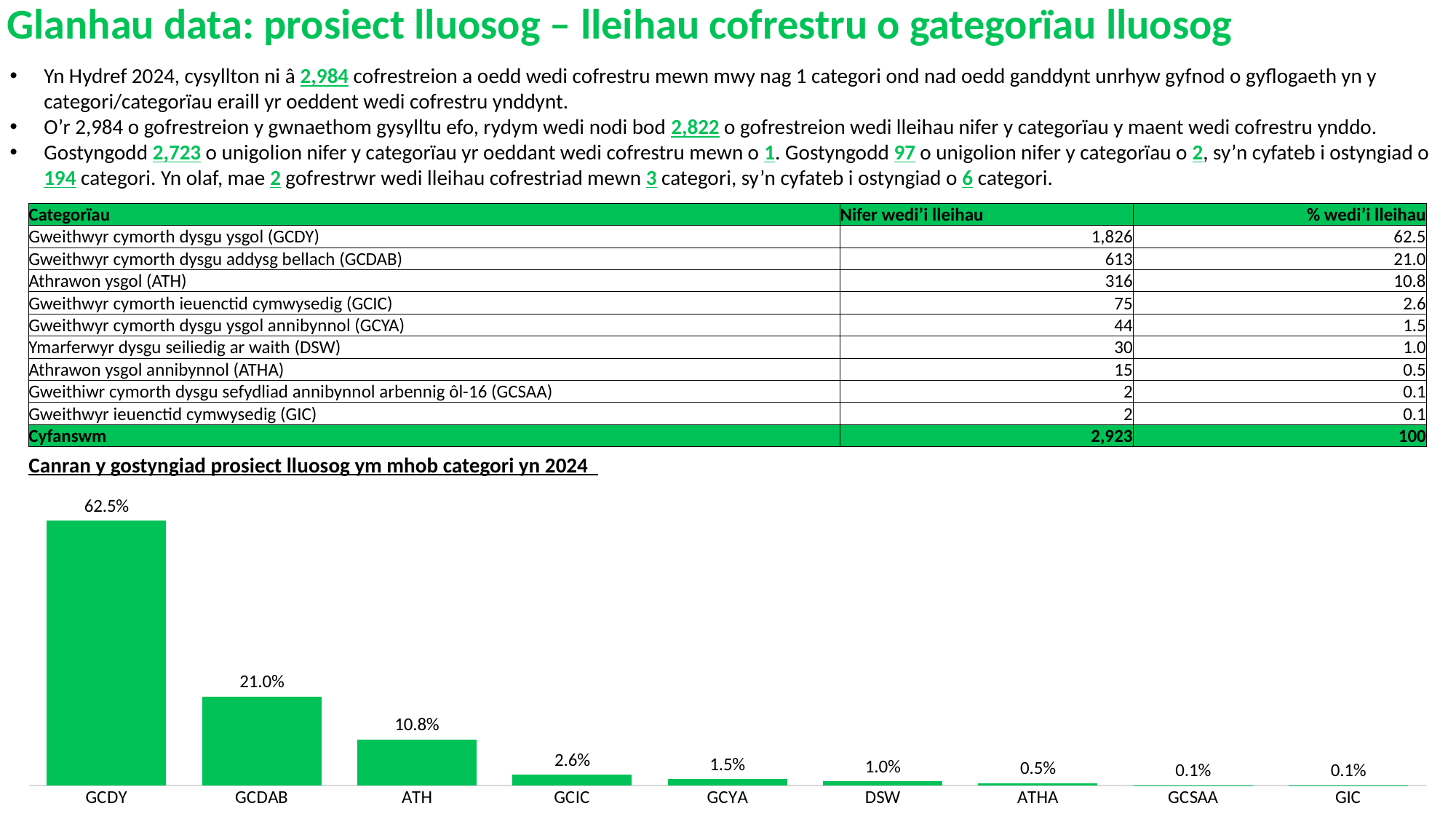
Do the values rise or fall from left to right along the x axis? Fall What kind of chart is shown on the slide? Bar chart Which is larger, the value for GCDAB or the value for ATH? GCDAB Which is larger, the value for DSW or the value for ATHA? DSW What is the value for GCDY in the chart? 62.5% What is the value for ATH in the chart? 10.8% Which category has the highest value in the chart? GCDY What is the difference between the values for ATH and GCIC? 8.2% How many categories are shown on the x axis of the chart? 9 What is the difference between the values for GCDY and GCDAB? 41.5% What is the value for GCYA in the chart? 1.5% What is the title of the chart? Canran y gostyngiad prosiect lluosog ym mhob categori yn 2024